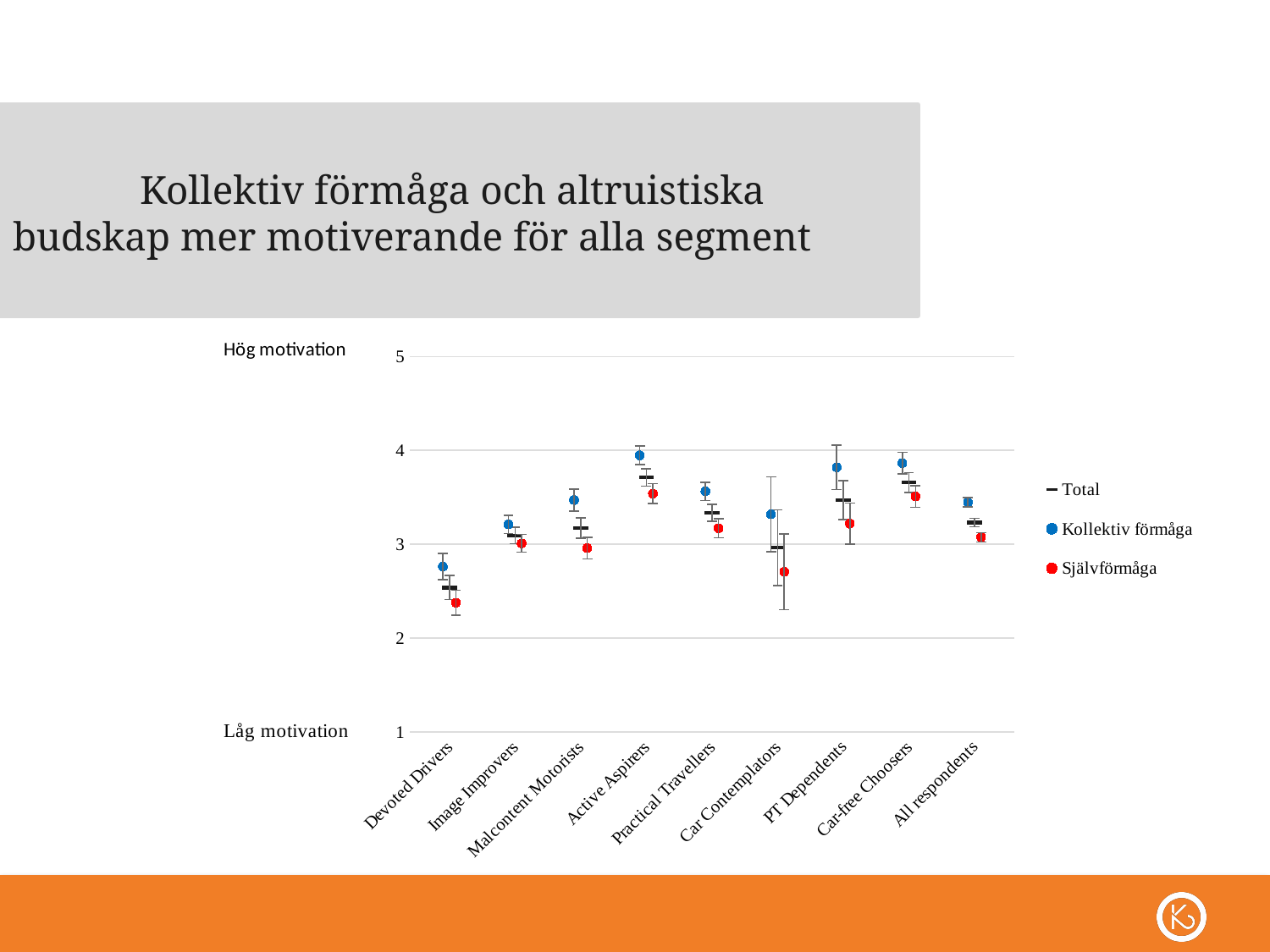
Is the Självförmåga value for Car Contemplators greater or less than 3? less What label appears next to the top of the y axis? Hög motivation Is the Kollektiv förmåga value for Devoted Drivers greater or less than 3? less Which category has the lowest Kollektiv förmåga value? Devoted Drivers Which series is shown with red markers in the chart? Självförmåga Which category has the lowest Självförmåga value? Devoted Drivers For Malcontent Motorists, which is larger: the Kollektiv förmåga value or the Självförmåga value? Kollektiv förmåga What type of chart is shown on the slide? Scatter (dot) chart with error bars How many series does the chart's legend list? 3 How many categories are shown along the x axis of the chart? 9 Is the Kollektiv förmåga value for PT Dependents greater or less than 3? greater